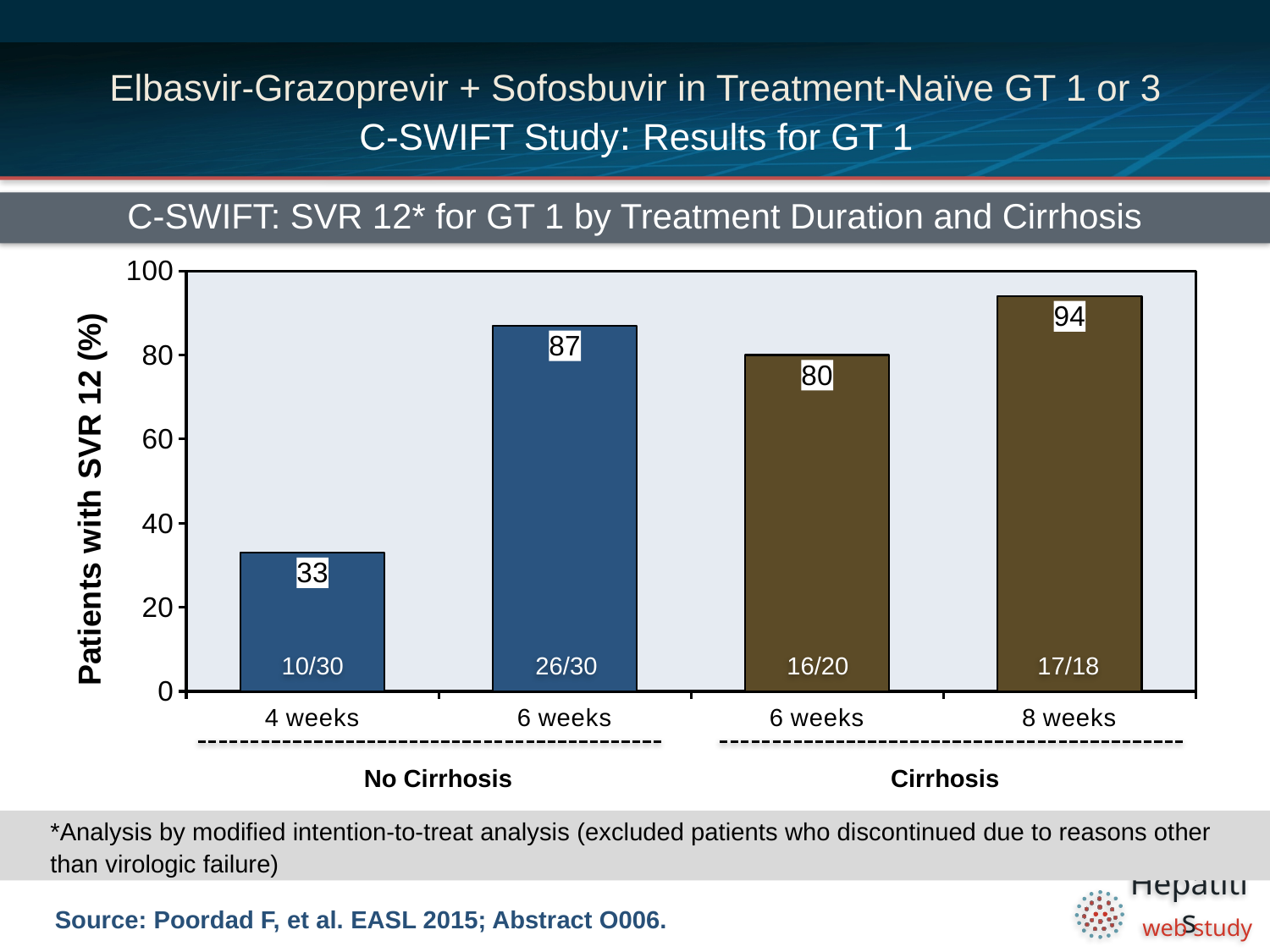
What is the SVR 12 rate for the 6 weeks group with cirrhosis? 80 What type of chart is shown on the slide? Bar chart How many bars are shown in the chart? 4 What is the title of the chart? C-SWIFT: SVR 12* for GT 1 by Treatment Duration and Cirrhosis Is the SVR 12 rate for the 4 weeks no cirrhosis group greater or less than 40? less What is the difference in SVR 12 rate between the 6 weeks and 4 weeks groups with no cirrhosis? 54 How many patients achieved SVR 12 out of the total in the 6 weeks no cirrhosis group? 26/30 What is the SVR 12 rate for the 4 weeks group with no cirrhosis? 33 Which group has the lowest SVR 12 rate? 4 weeks, No Cirrhosis Which has a higher SVR 12 rate: 6 weeks with no cirrhosis or 6 weeks with cirrhosis? 6 weeks with no cirrhosis What is the SVR 12 rate for the 8 weeks group with cirrhosis? 94 Which group has the highest SVR 12 rate? 8 weeks, Cirrhosis